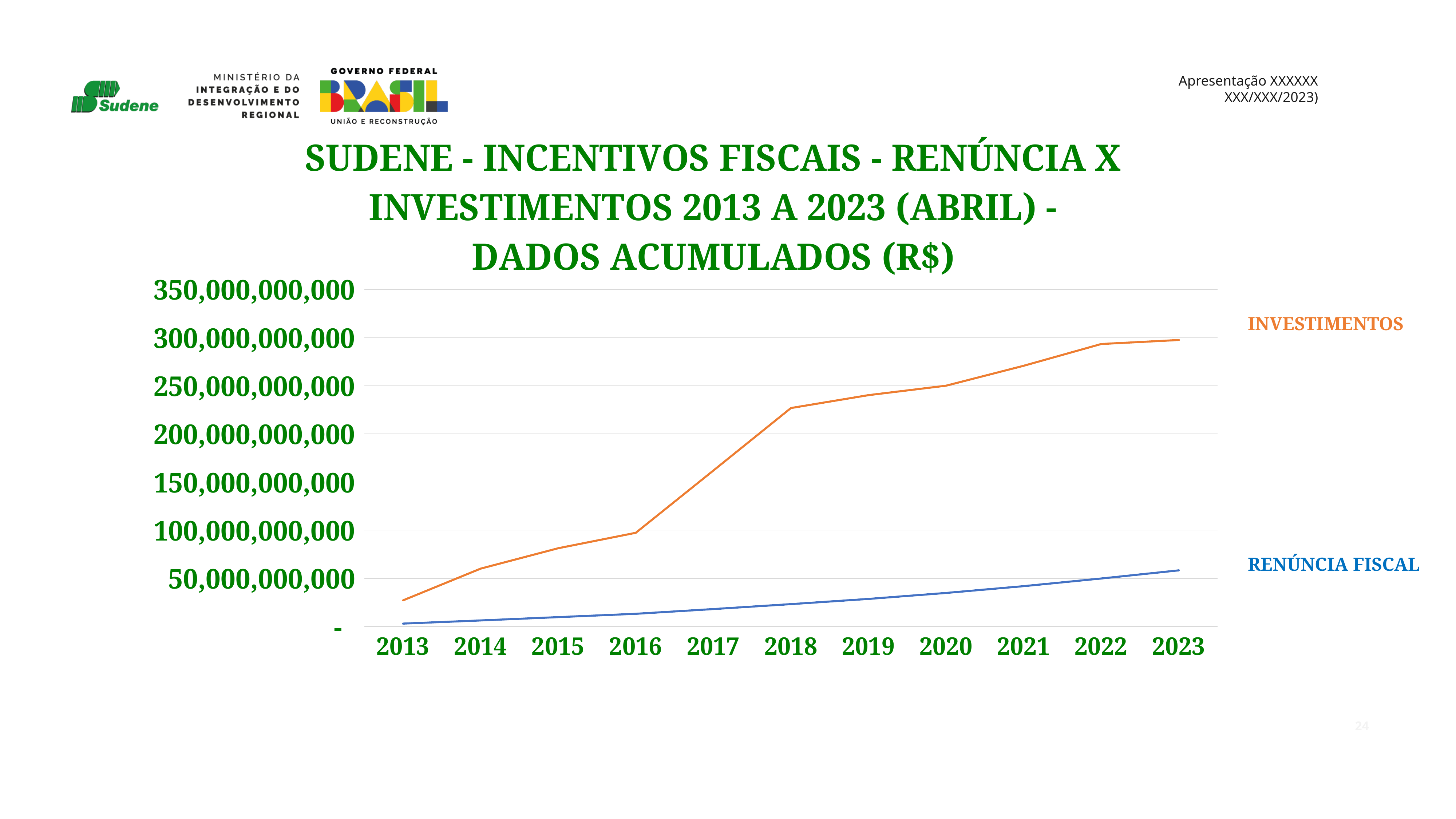
What kind of chart is shown on the slide? line chart What is the title of the chart? SUDENE - INCENTIVOS FISCAIS - RENÚNCIA X INVESTIMENTOS 2013 A 2023 (ABRIL) - DADOS ACUMULADOS (R$) Is the RENÚNCIA FISCAL value for 2019 greater or less than 50,000,000,000? less In which year is the INVESTIMENTOS value highest? 2023 In which year is the RENÚNCIA FISCAL value lowest? 2013 Which series is drawn in orange? INVESTIMENTOS Do the INVESTIMENTOS values rise or fall from 2013 to 2023? rise How many series does the chart show? 2 Is the INVESTIMENTOS value for 2018 greater or less than 200,000,000,000? greater Do the RENÚNCIA FISCAL values rise or fall from 2013 to 2023? rise In 2023, which series has the larger value, INVESTIMENTOS or RENÚNCIA FISCAL? INVESTIMENTOS How many years are plotted along the x axis? 11